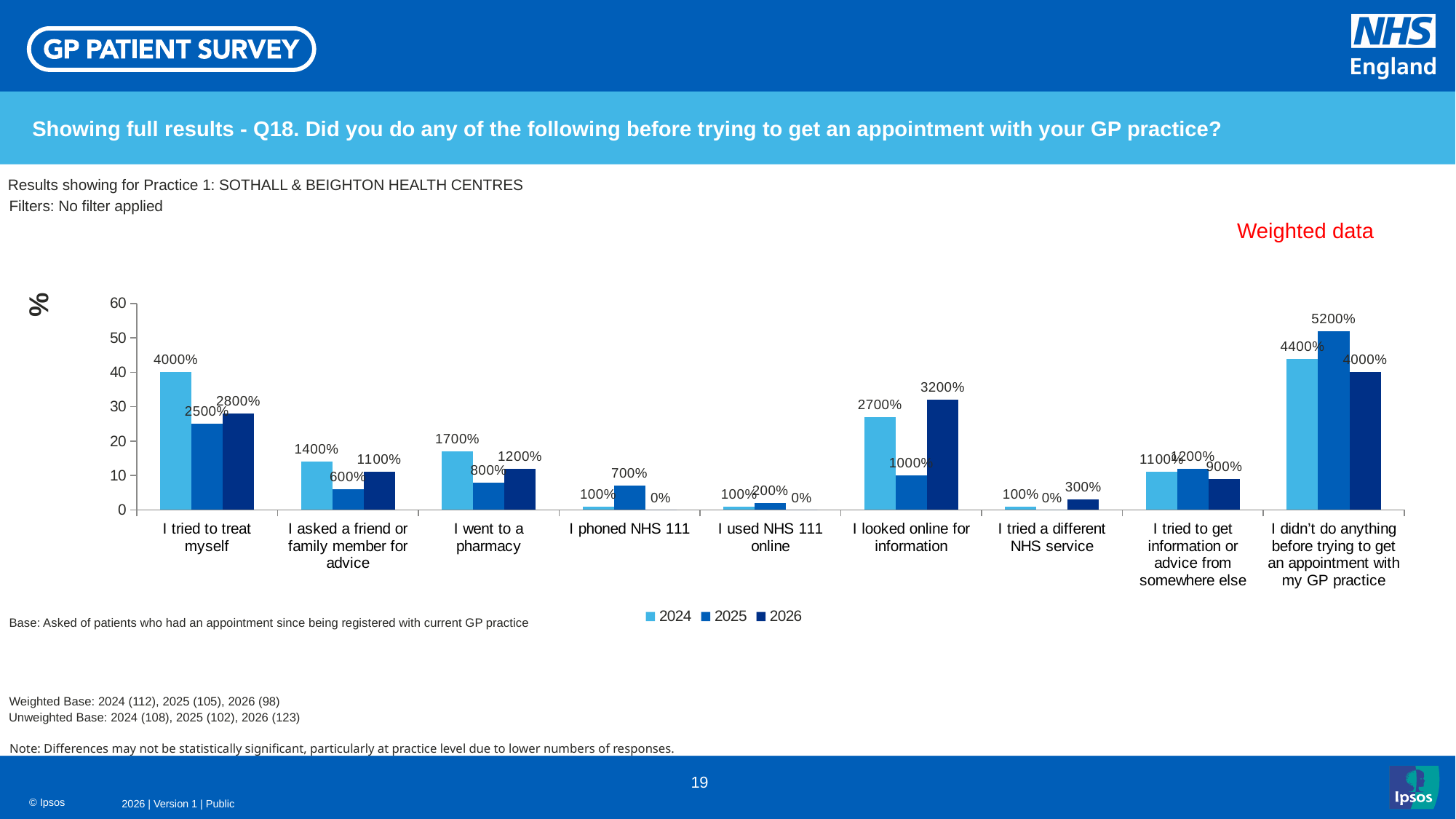
What type of chart is shown on the slide? Bar chart What is the 2025 value for 'I phoned NHS 111'? 700% How many categories are shown on the x axis? 9 Which category has the lowest 2026 value? I phoned NHS 111 and I used NHS 111 online (both 0%) How many series does the legend list? 3 What is the 2026 value for 'I looked online for information'? 3200% For 'I went to a pharmacy', which year has the larger value, 2024 or 2026? 2024 Which category has the highest 2025 value? I didn't do anything before trying to get an appointment with my GP practice What is the difference between the 2025 and 2026 values for 'I didn't do anything before trying to get an appointment with my GP practice'? 1200% What are the legend entries for the chart? 2024, 2025, 2026 Is the 2024 bar for 'I looked online for information' greater or less than 20 on the y axis? greater What is the 2024 value for 'I tried to treat myself'? 4000%